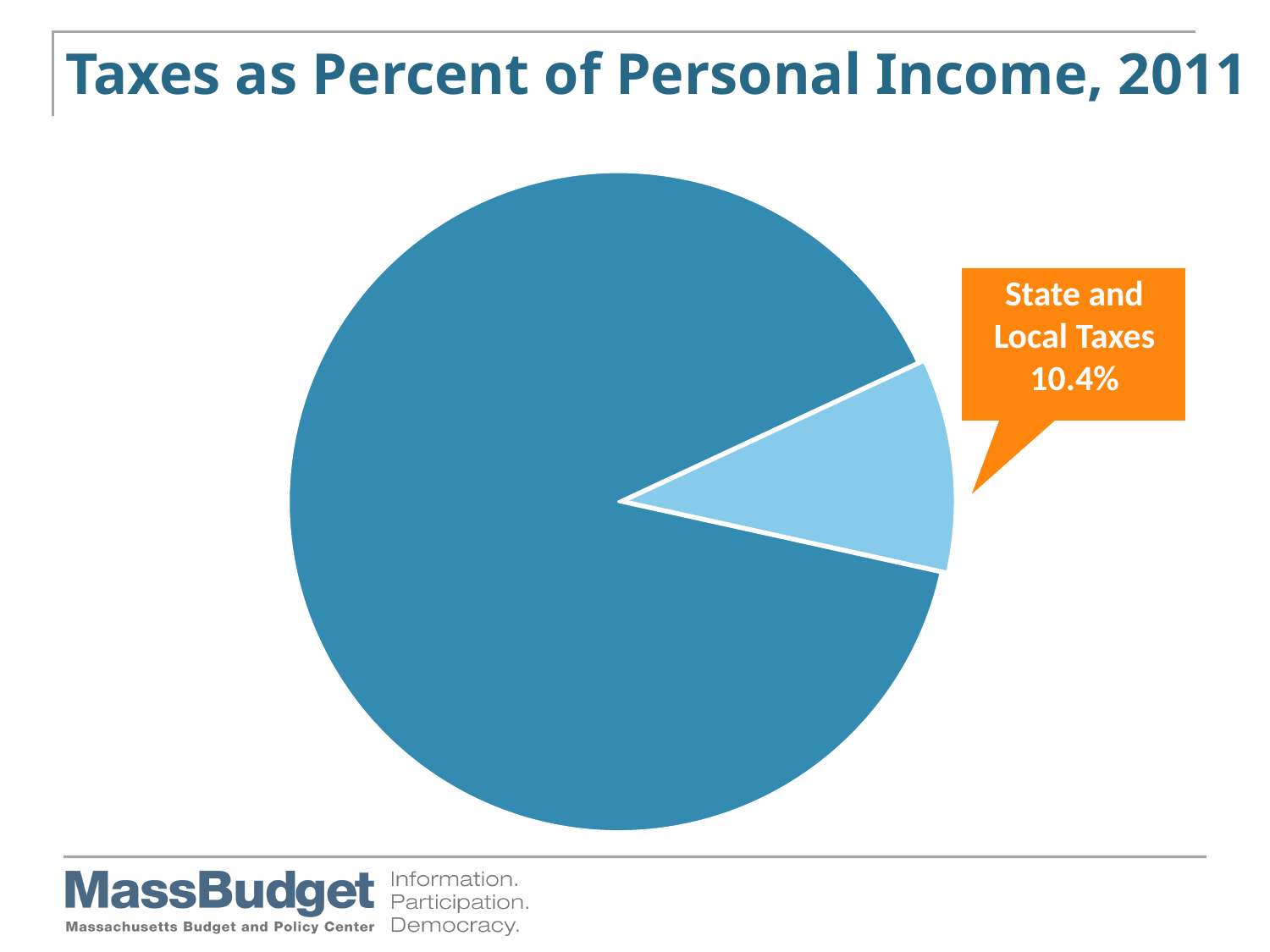
What colour is the State and Local Taxes slice? light blue Is the value for State and Local Taxes greater or less than 50%? less What is the title of the chart? Taxes as Percent of Personal Income, 2011 What percentage of personal income is shown for State and Local Taxes? 10.4% What kind of chart is shown on the slide? pie chart What share of the pie does the State and Local Taxes slice represent? 10.4% How many slices does the pie chart have? 2 Is the State and Local Taxes slice the larger or the smaller slice of the pie? smaller Which year does the chart refer to? 2011